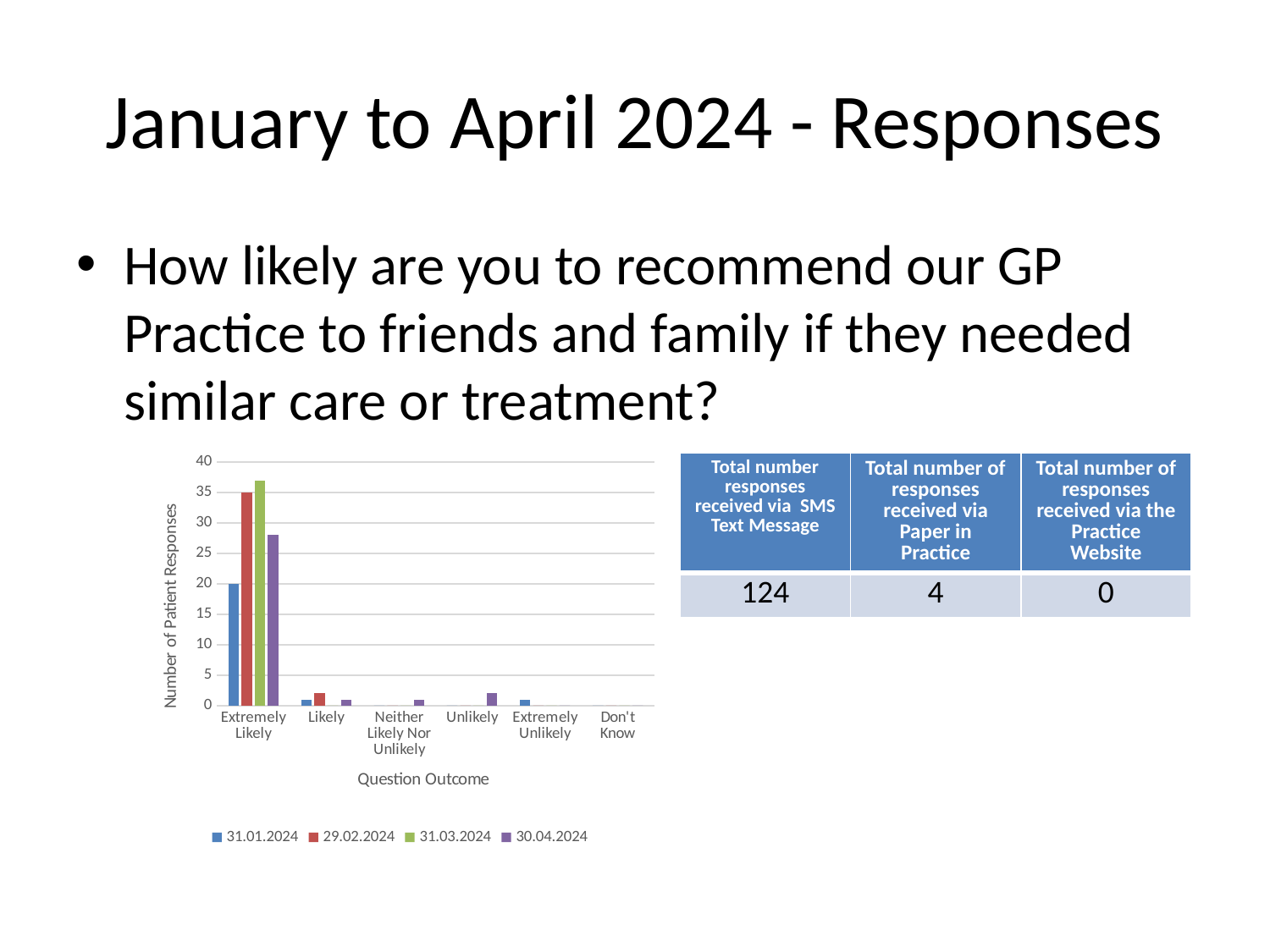
For the Extremely Likely category, which is larger: the value for 29.02.2024 or the value for 30.04.2024? 29.02.2024 What is the title of the horizontal axis of the chart? Question Outcome Is the value for 30.04.2024 in the Extremely Likely category greater or less than 30? less Is the value for 31.03.2024 in the Extremely Likely category greater or less than 35? greater Which question outcome category has the tallest bars in the chart? Extremely Likely How many question outcome categories are shown on the x axis of the chart? 6 What kind of chart is shown on the slide? bar chart For the Extremely Likely category, which series has the lowest bar? 31.01.2024 For the Extremely Likely category, which series has the highest bar? 31.03.2024 What is the value for 31.01.2024 in the Extremely Likely category? 20 What is the title of the vertical axis of the chart? Number of Patient Responses How many series does the chart legend list? 4